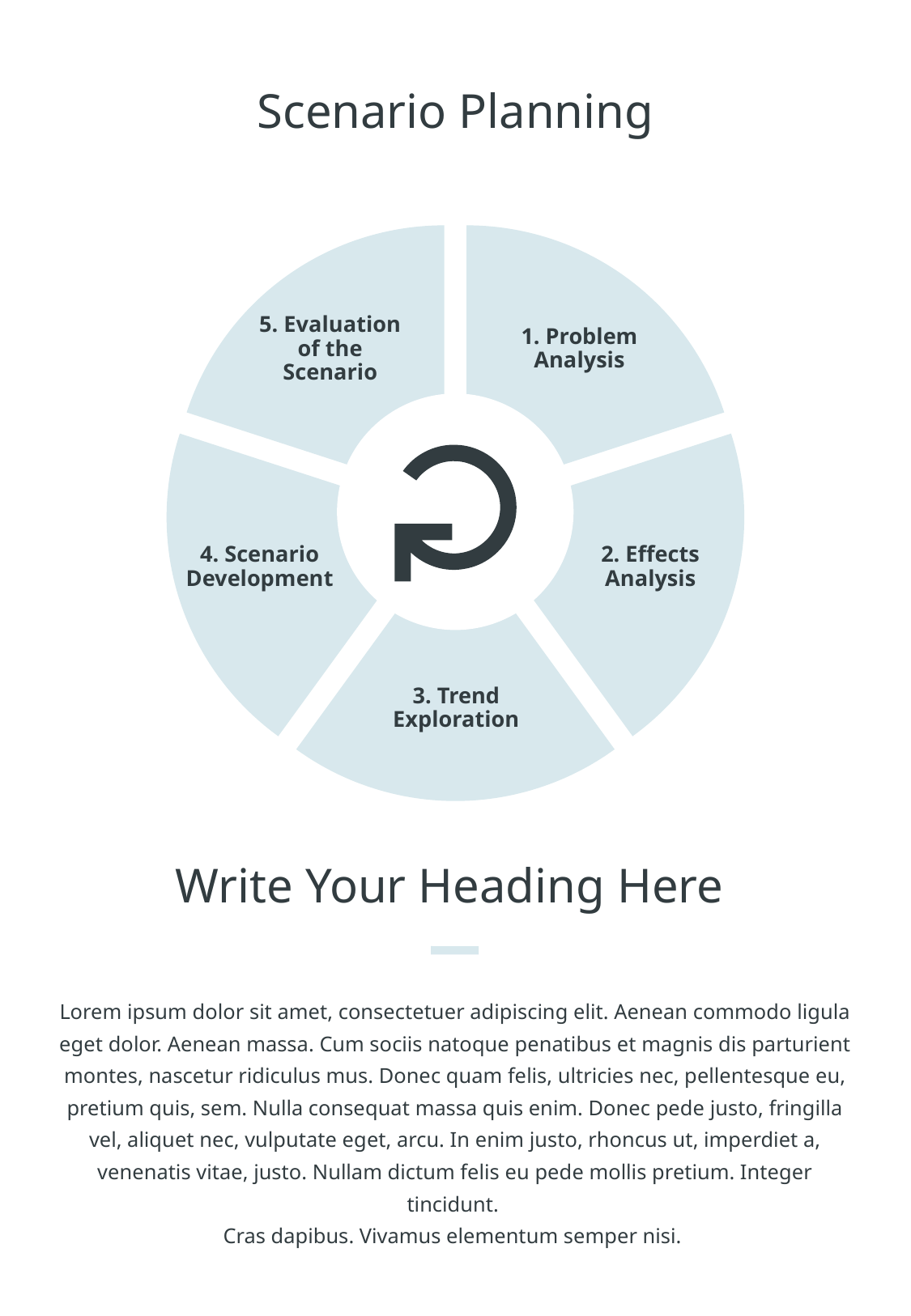
What is the label of step 3 in the circular diagram? Trend Exploration Which step number is labelled "Scenario Development" in the circular diagram? 4 What is the label of the last (fifth) step in the circular diagram? Evaluation of the Scenario How many segments does the circular diagram on the slide contain? 5 What kind of graphic is shown on the slide: a bar chart, a line chart, or a circular process diagram? circular process diagram What is the label of step 1 in the circular diagram? Problem Analysis What is the title above the circular diagram? Scenario Planning Which step number is labelled "Effects Analysis" in the circular diagram? 2